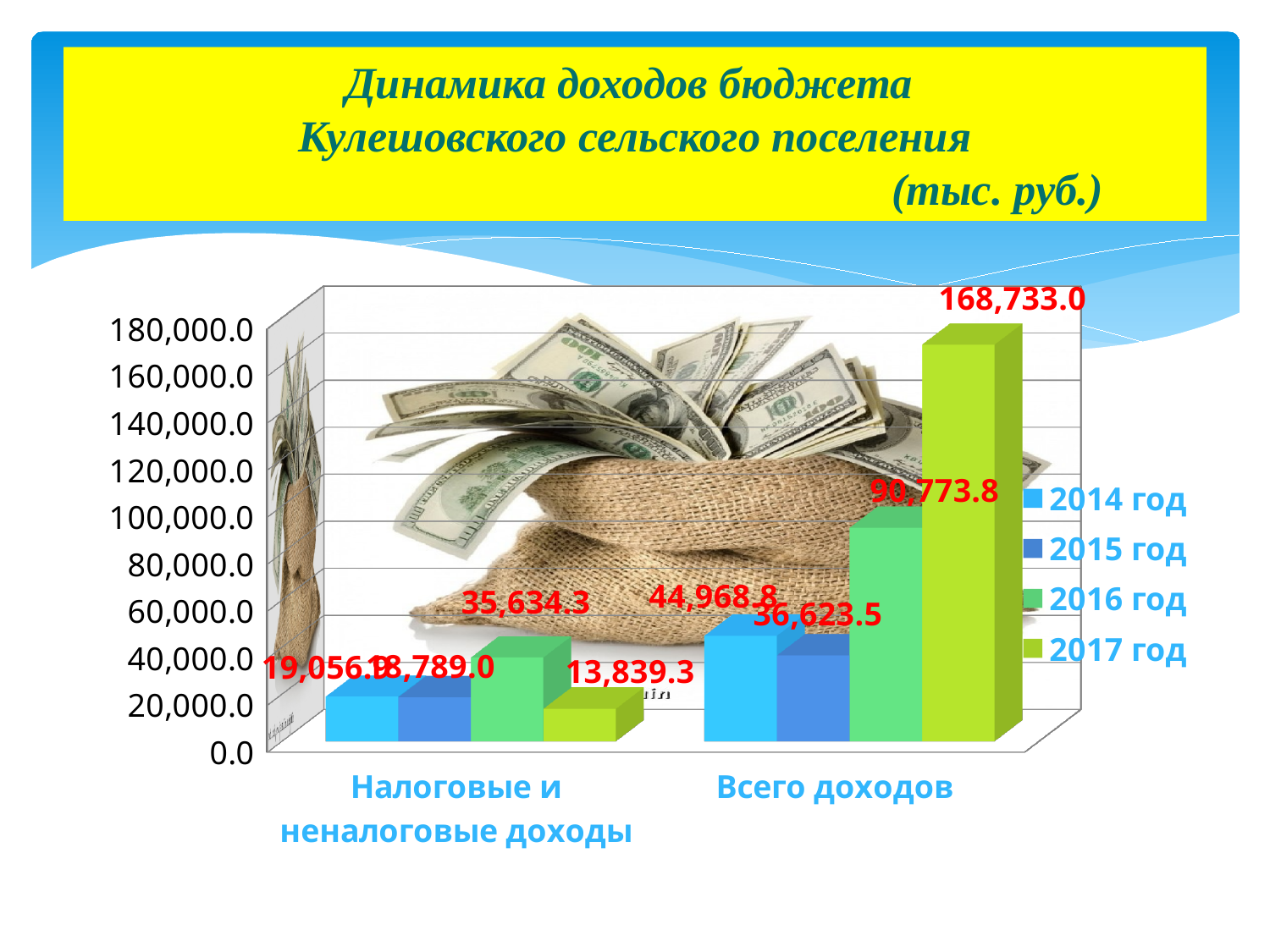
What kind of chart is shown on the slide? bar chart What is the value for 2017 год in the Налоговые и неналоговые доходы category? 13,839.3 What is the value for 2015 год in the Всего доходов category? 36,623.5 What is the value for 2016 год in the Налоговые и неналоговые доходы category? 35,634.3 In the Всего доходов category, which is larger: the value for 2014 год or for 2015 год? 2014 год How many series does the legend list? 4 Which year has the highest value in the Всего доходов category? 2017 год How many categories are shown on the x axis? 2 What is the value for 2017 год in the Всего доходов category? 168,733.0 What is the value for 2016 год in the Всего доходов category? 90,773.8 What is the difference between the 2017 год and 2016 год values in the Всего доходов category? 77,959.2 What is the value for 2014 год in the Всего доходов category? 44,968.8